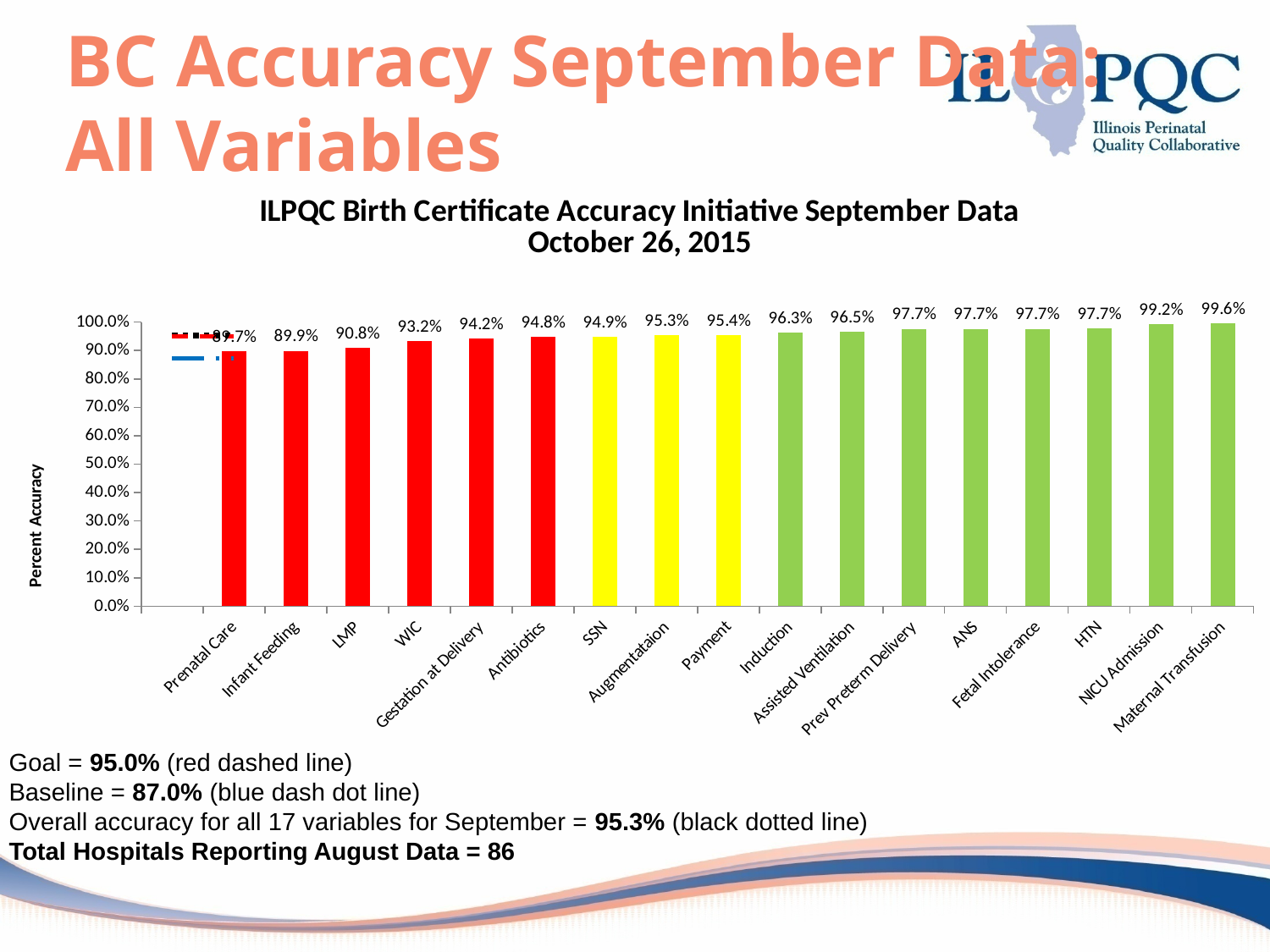
What is the value for Fetal Intolerance? 97.7% What is the difference between the values for Maternal Transfusion and LMP? 8.8 percentage points Do the values rise or fall from left to right along the x axis? rise Which is larger, the value for Payment or the value for Antibiotics? Payment Is the value for Assisted Ventilation greater or less than 90.0%? greater What kind of chart is this? bar chart What is the value for Induction? 96.3% How many categories are shown on the x axis? 17 What is the value for NICU Admission? 99.2% Which category has the highest value? Maternal Transfusion What is the value for WIC? 93.2% What is the difference between the values for Augmentataion and Gestation at Delivery? 1.1 percentage points